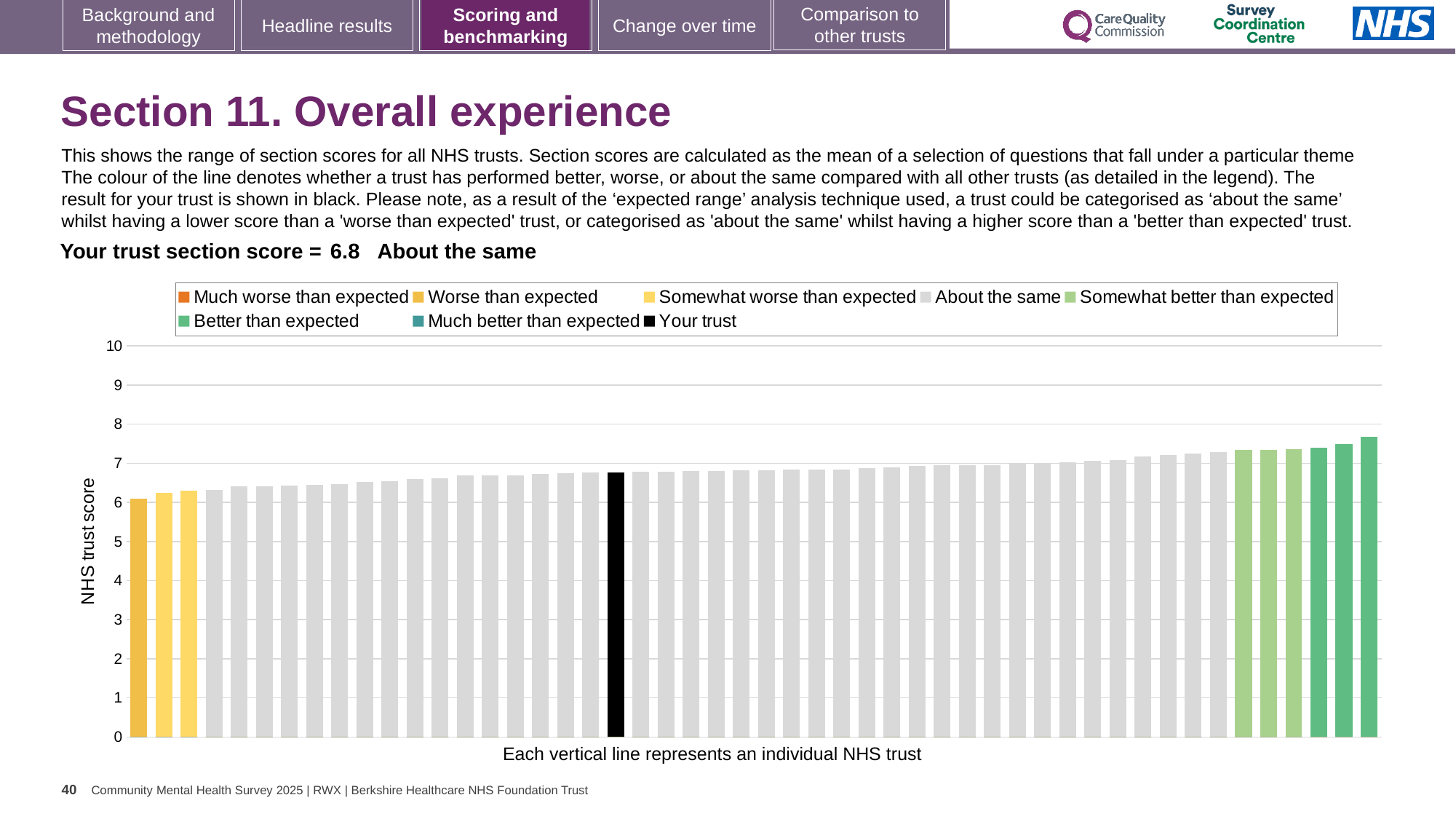
Is the value of the lowest bar (leftmost) greater or less than 5? greater How many entries does the chart legend list? 8 Is the value for your trust (the black bar) greater or less than 6? greater Which category is your trust's section score placed in? About the same What is the label on the vertical axis of the chart? NHS trust score Do the bar values rise or fall from left to right along the x axis? rise Which is larger, the rightmost bar or the black bar for your trust? the rightmost bar What is the section score for your trust shown on the slide? 6.8 Is the value of the highest bar (rightmost) greater or less than 7? greater What kind of chart is shown on the slide? Bar chart